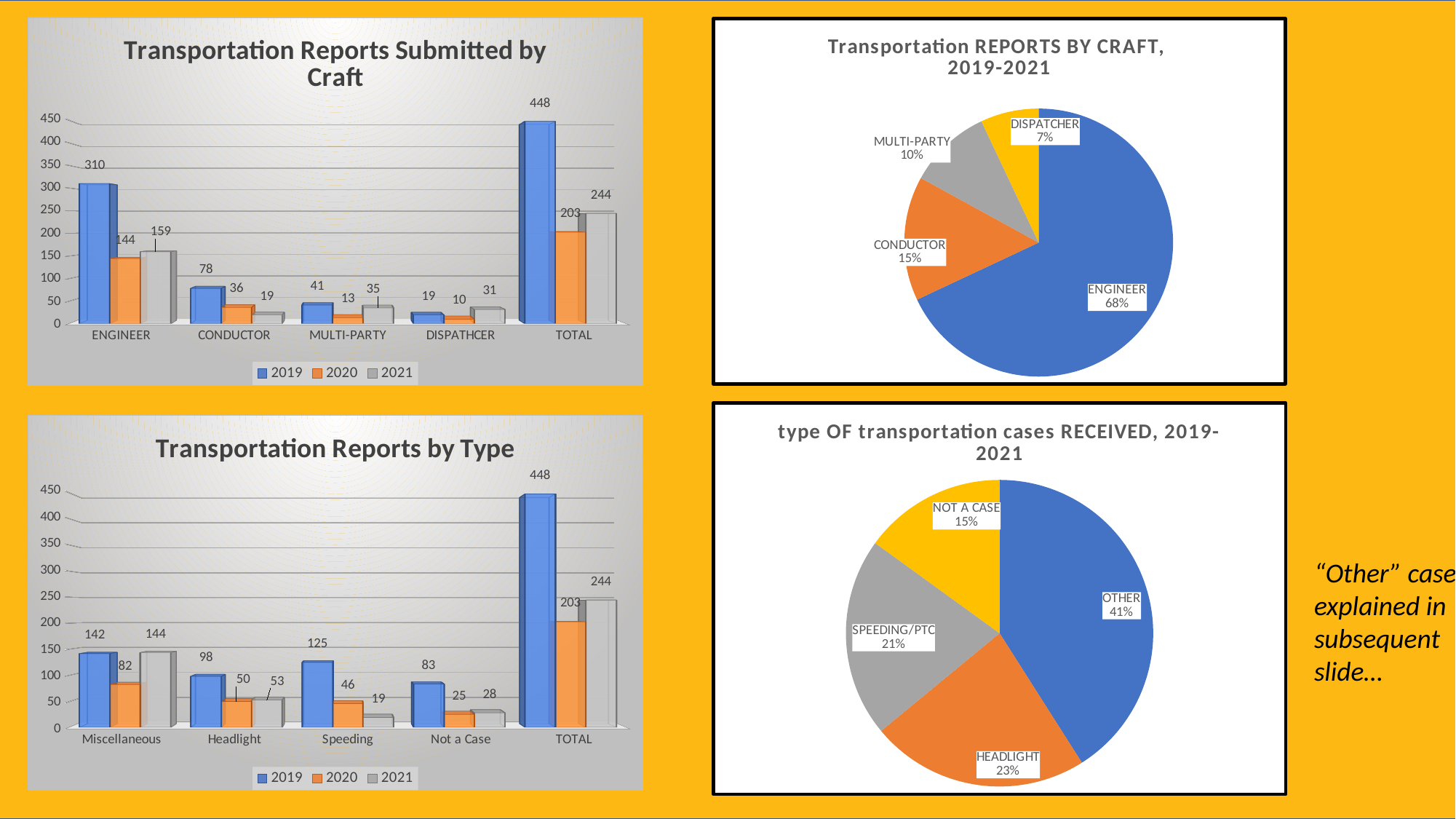
In the 'Transportation Reports Submitted by Craft' chart, what is the difference between the 2019 and 2020 values for ENGINEER? 166 In the 'Transportation REPORTS BY CRAFT, 2019-2021' pie chart, what share does ENGINEER have? 68% How many series does the legend list in the 'Transportation Reports Submitted by Craft' chart? 3 What type of chart is 'Transportation Reports by Type'? Bar chart In the 'type OF transportation cases RECEIVED, 2019-2021' pie chart, what share does HEADLIGHT have? 23% In the 'Transportation Reports Submitted by Craft' chart, which craft (excluding TOTAL) has the lowest value in 2020? DISPATHCER In the 'Transportation Reports Submitted by Craft' chart, what is the value for ENGINEER in 2019? 310 In the 'Transportation Reports by Type' chart, which is larger: Headlight in 2020 or Speeding in 2020? Headlight in 2020 In the 'Transportation REPORTS BY CRAFT, 2019-2021' pie chart, which craft has the smallest slice? DISPATCHER In the 'Transportation Reports Submitted by Craft' chart, what is the value for CONDUCTOR in 2021? 19 In the 'Transportation Reports by Type' chart, what is the difference between the 2021 and 2020 values for Miscellaneous? 62 In the 'Transportation Reports by Type' chart, what is the value for Speeding in 2019? 125